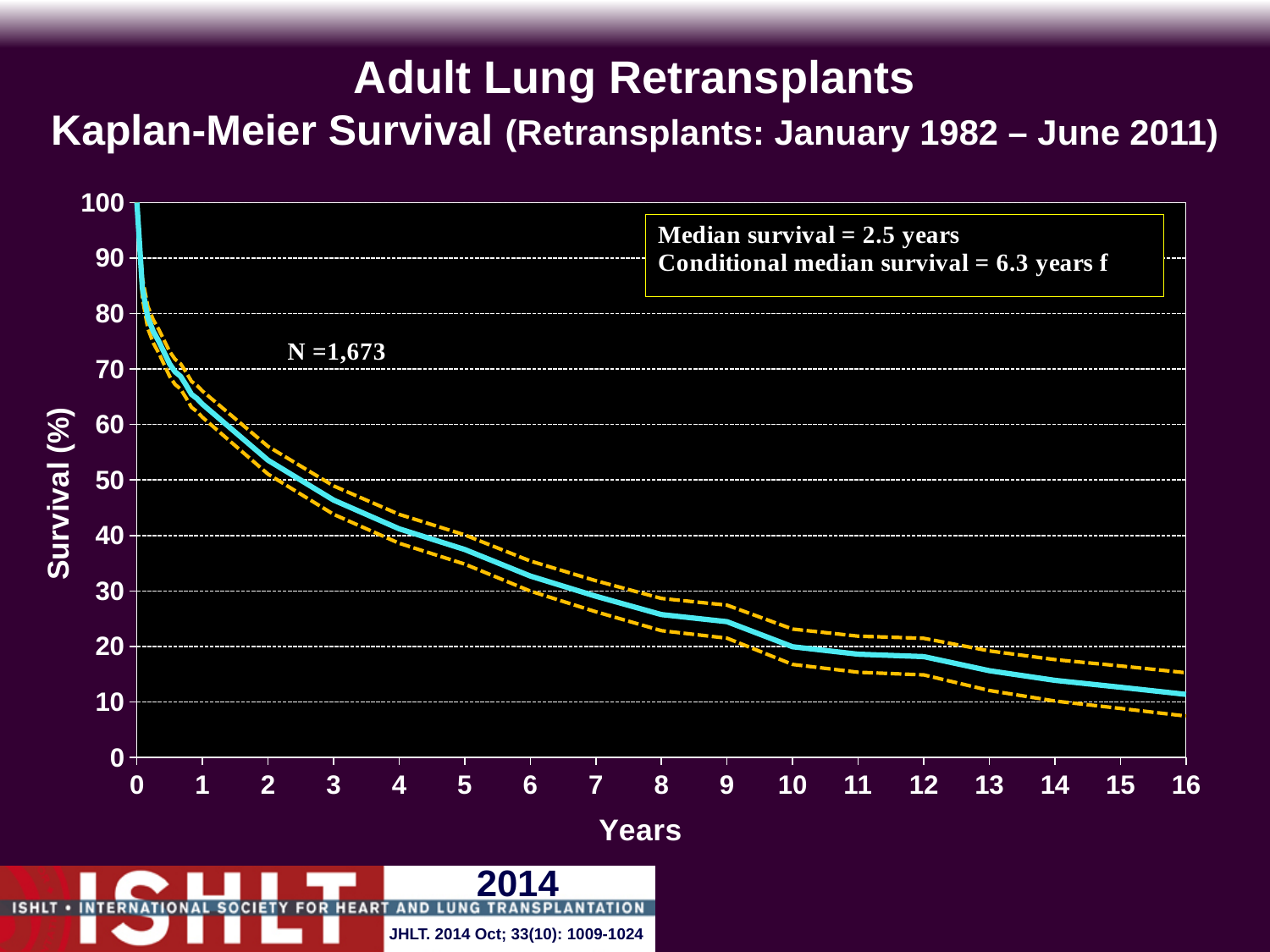
Is the survival value at 16 years greater or less than 20? less Is the survival value at 3 years greater or less than 50? less What is the label of the y axis? Survival (%) Does the survival curve rise or fall as years increase? fall What is the value of N shown on the chart? 1,673 What is the median survival stated on the chart? 2.5 years Is the survival value at 14 years greater or less than 10? greater What is the highest value shown on the y axis? 100 What is the conditional median survival stated on the chart? 6.3 years What is the label of the x axis? Years What kind of chart is shown on the slide? line chart